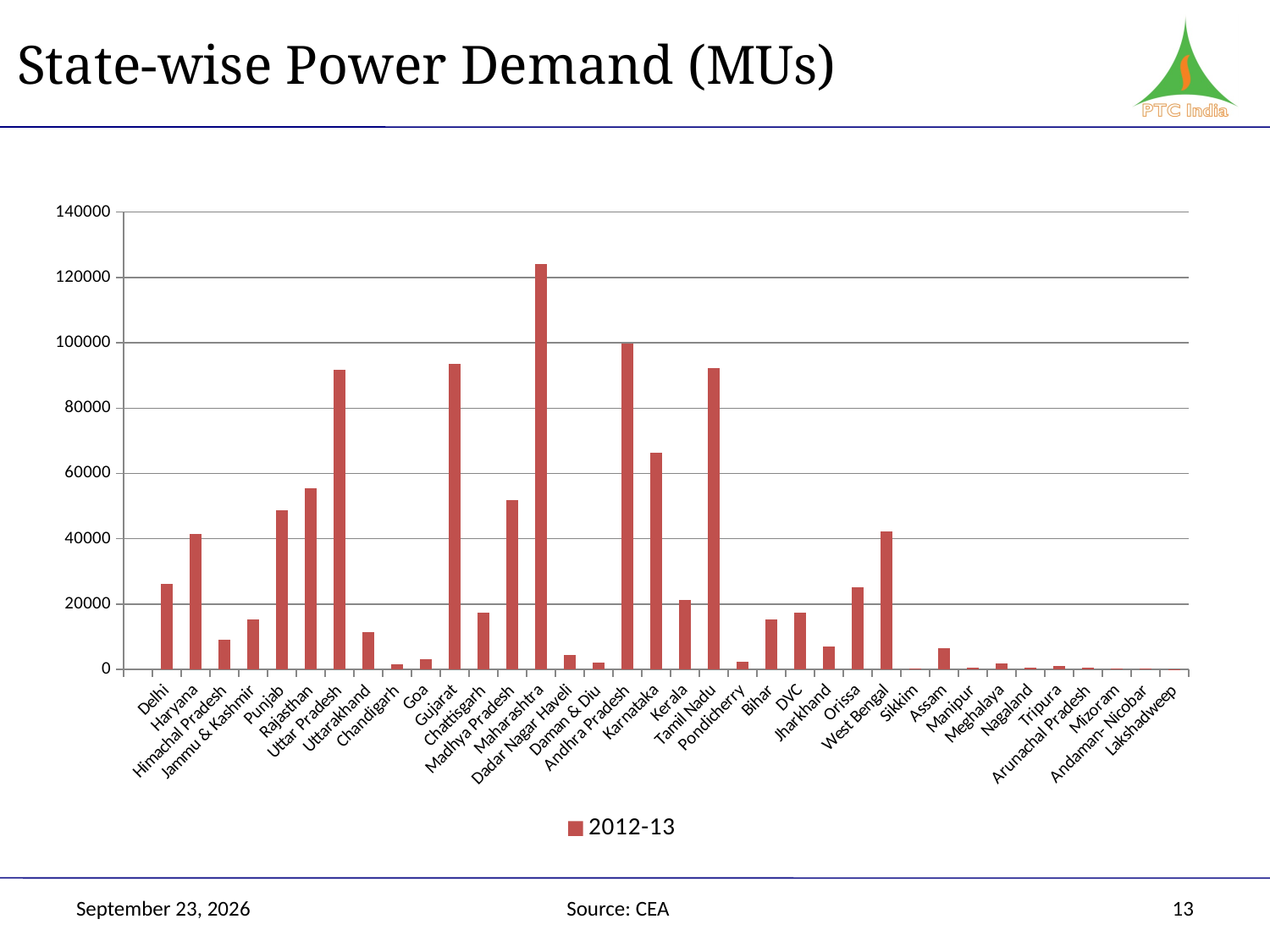
Is the value for Maharashtra greater or less than 120000? greater What is the legend entry for the series shown? 2012-13 Is the value for Rajasthan greater or less than 60000? less Is the value for Uttar Pradesh greater or less than 80000? greater Which state has the highest power demand in the chart? Maharashtra How many states/categories are plotted on the x axis? 36 Which is larger, the value for Delhi or the value for Haryana? Haryana Which is larger, the value for Maharashtra or the value for Andhra Pradesh? Maharashtra What kind of chart is shown on the slide? bar chart Which is larger, the value for Tamil Nadu or the value for Karnataka? Tamil Nadu How many series does the legend list? 1